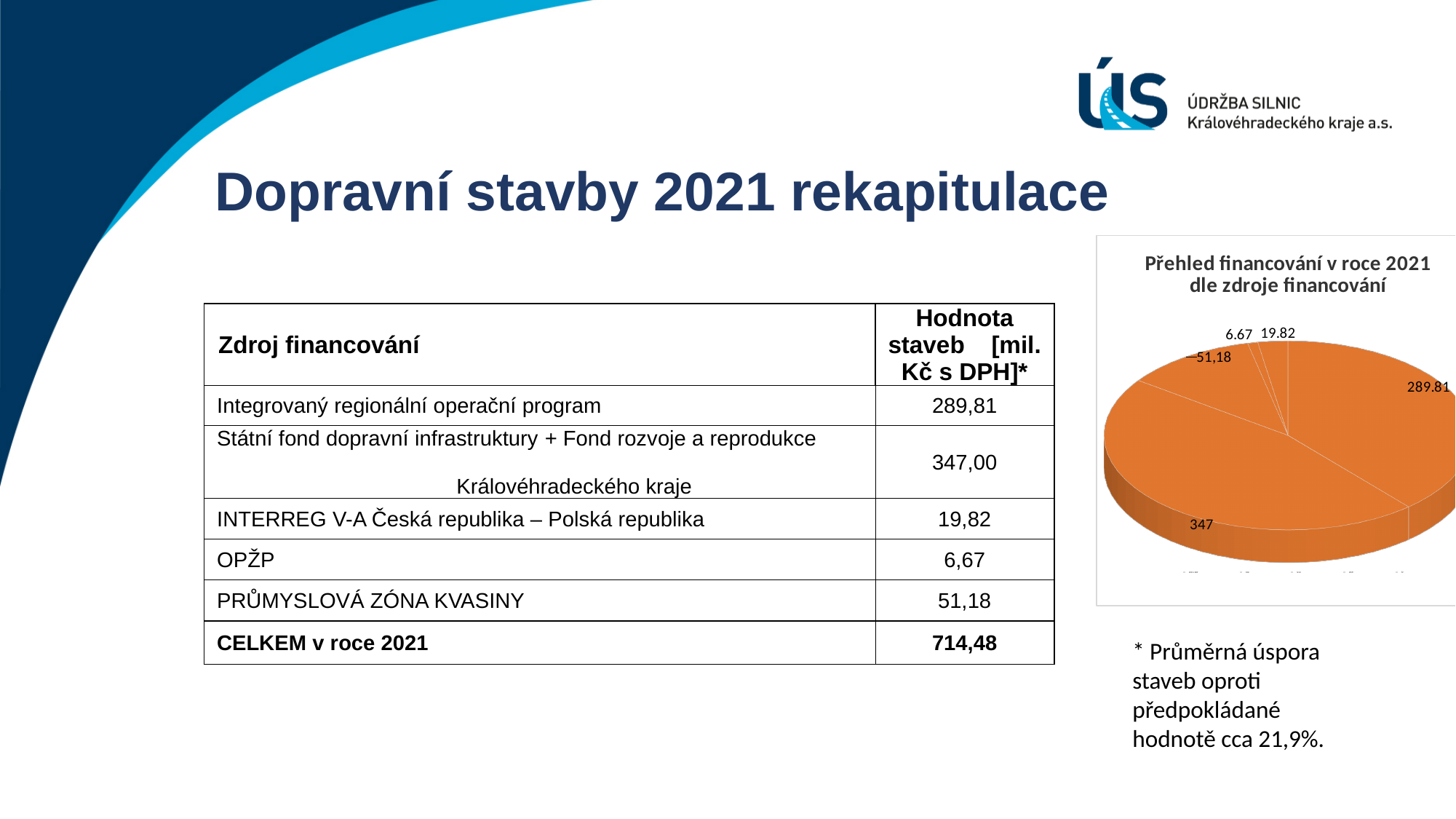
According to the table, what value is shown for Integrovaný regionální operační program? 289,81 What is the difference between the two largest slice values in the pie chart (347 and 289.81)? 57.19 What is the value of the largest slice in the pie chart? 347 What kind of chart is shown on the slide? pie chart Is the slice labelled 289.81 larger or smaller than the slice labelled 347? smaller How many slices does the pie chart have? 5 According to the table, what value is shown for OPŽP? 6,67 Which slice value is larger in the pie chart, 51,18 or 19.82? 51,18 What colour are the slices of the pie chart? orange What is the title of the pie chart? Přehled financování v roce 2021 dle zdroje financování What is the value of the smallest slice in the pie chart? 6.67 What is the total of all slice values in the pie chart, as given in the table's CELKEM row? 714,48